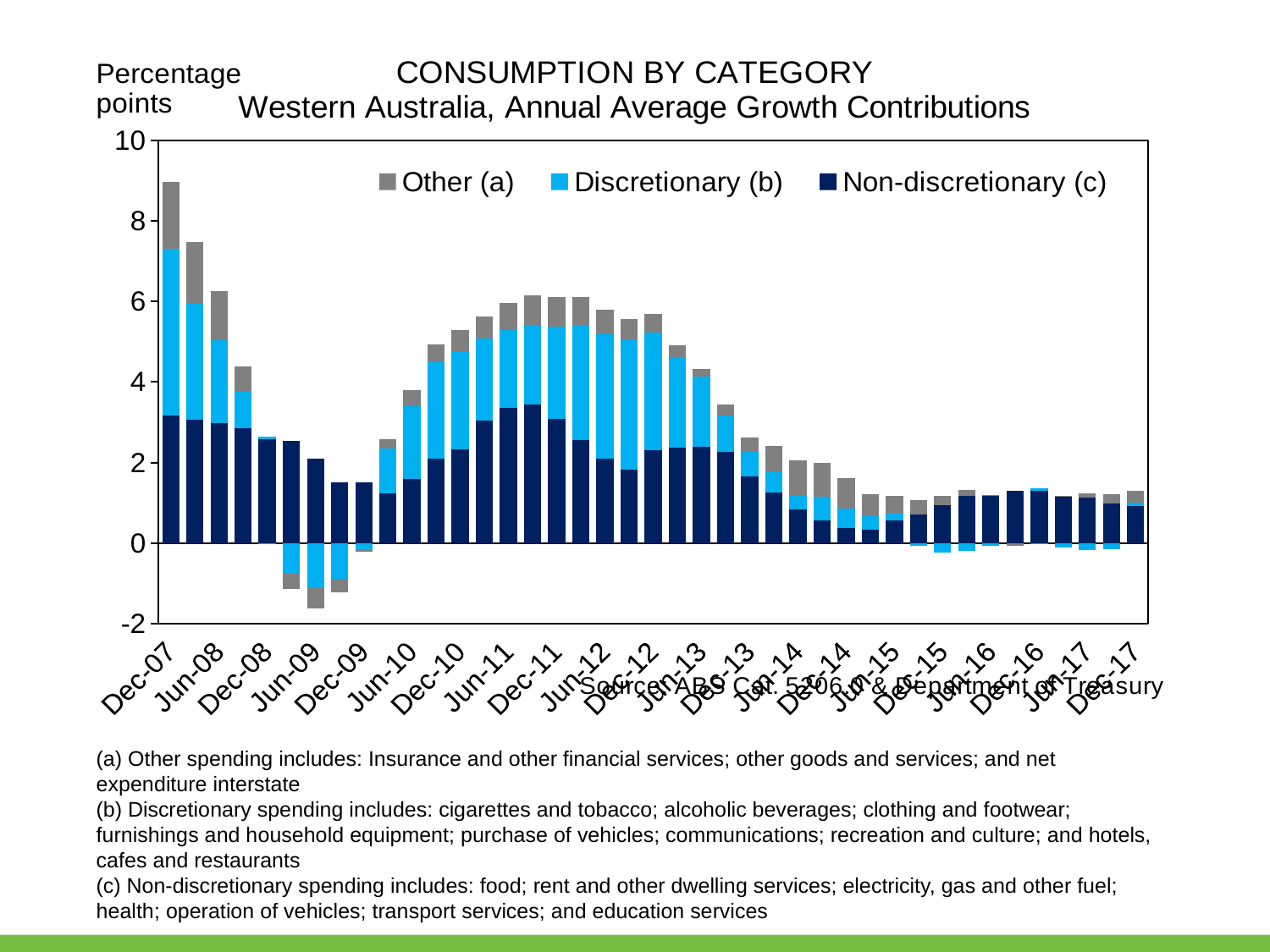
Which period has the highest total bar? Dec-07 Is the total bar for Dec-17 greater or less than 2? less Do the total bars rise or fall from Dec-07 to Jun-09? fall How many series does the legend list? 3 Which total bar is larger, Dec-07 or Dec-17? Dec-07 Is the total bar for Dec-07 greater or less than 8? greater Is the Non-discretionary (c) value for Dec-07 greater or less than 2? greater What are the three series named in the legend? Other (a), Discretionary (b), Non-discretionary (c) What is the title of the chart? CONSUMPTION BY CATEGORY What kind of chart is shown on the slide? Stacked bar chart